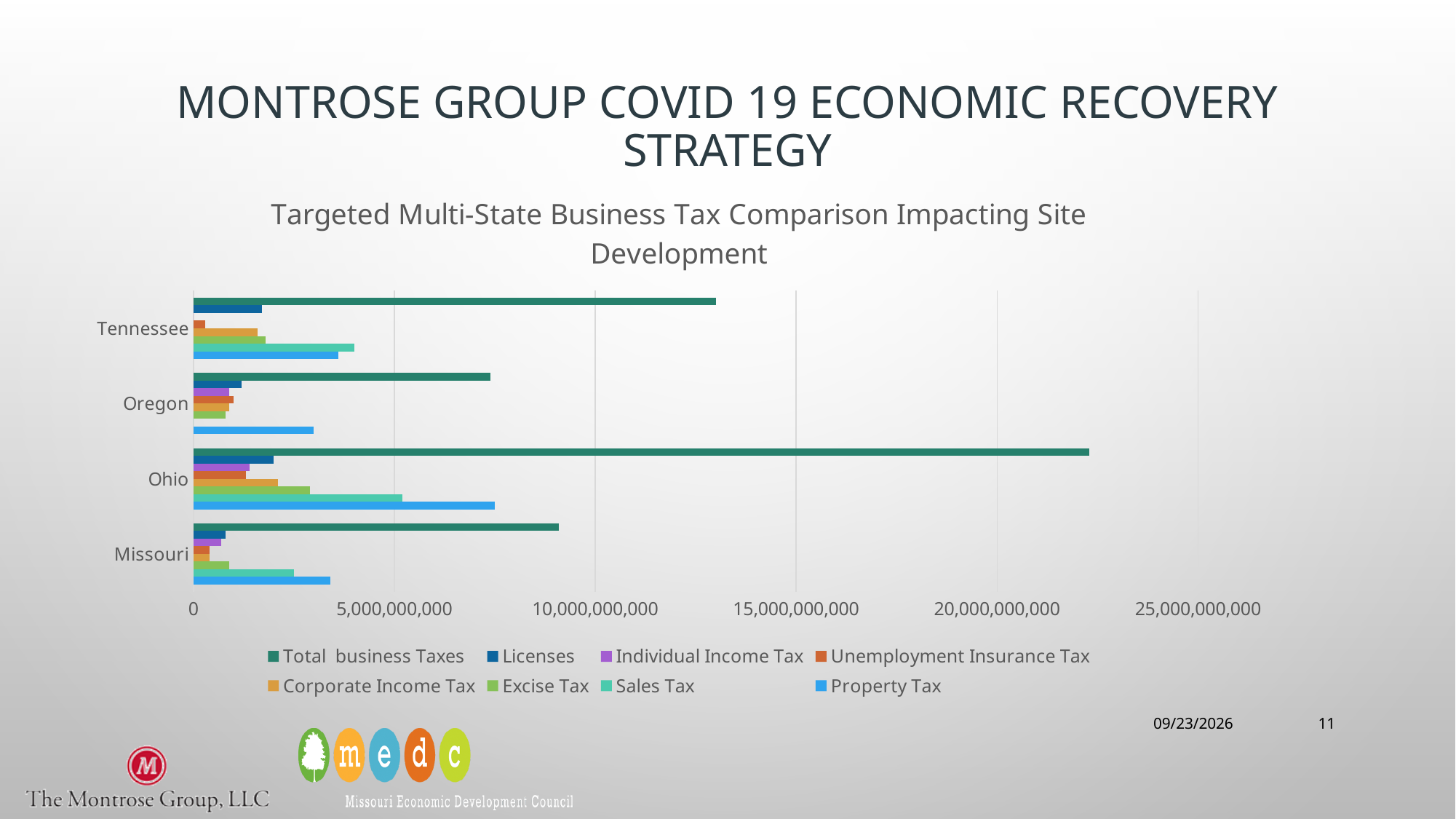
Which state has the highest Property Tax? Ohio How many series does the legend list? 8 What kind of chart is shown on the slide? Bar chart Which is larger, the Sales Tax for Ohio or for Oregon? Ohio Is the Total business Taxes value for Tennessee greater or less than 10,000,000,000? greater Which state has the highest Total business Taxes? Ohio Is the Total business Taxes value for Missouri greater or less than 10,000,000,000? less Which state has the lowest Total business Taxes? Oregon How many states are shown on the chart? 4 Which is larger, the Total business Taxes for Tennessee or for Missouri? Tennessee What is the title of the chart? Targeted Multi-State Business Tax Comparison Impacting Site Development Is the Total business Taxes value for Ohio greater or less than 20,000,000,000? greater